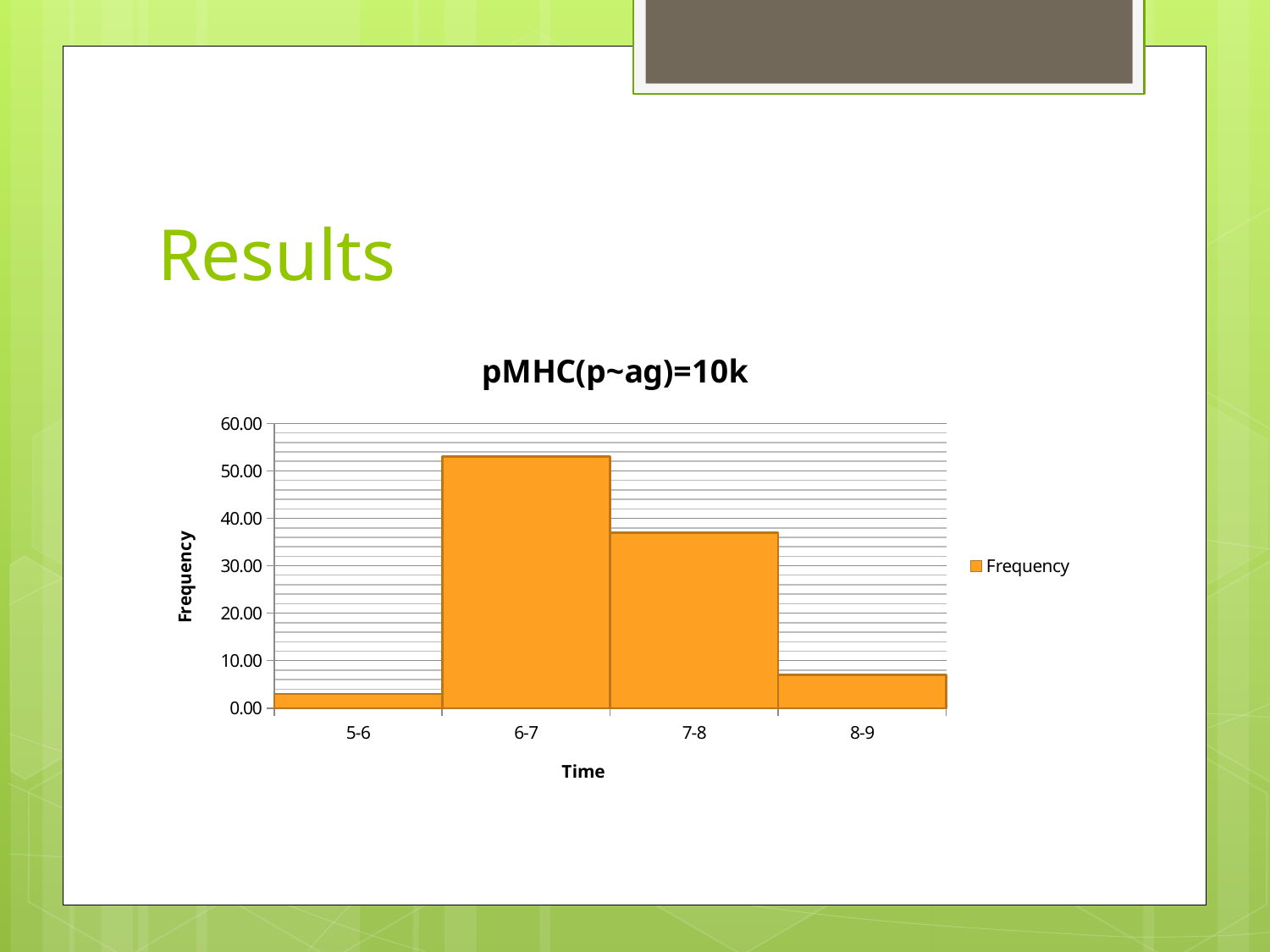
Which time category has the lowest frequency? 5-6 Does the frequency rise or fall from 6-7 to 8-9? fall Which has a higher frequency, 7-8 or 8-9? 7-8 Is the frequency for 8-9 greater or less than 10.00? less What is the title of the chart? pMHC(p~ag)=10k Which time category has the highest frequency? 6-7 How many time categories are shown on the x axis? 4 Is the frequency for 7-8 greater or less than 40.00? less Is the frequency for 6-7 greater or less than 50.00? greater What is the label of the vertical axis? Frequency How many series does the legend list? 1 What kind of chart is shown on the slide? bar chart